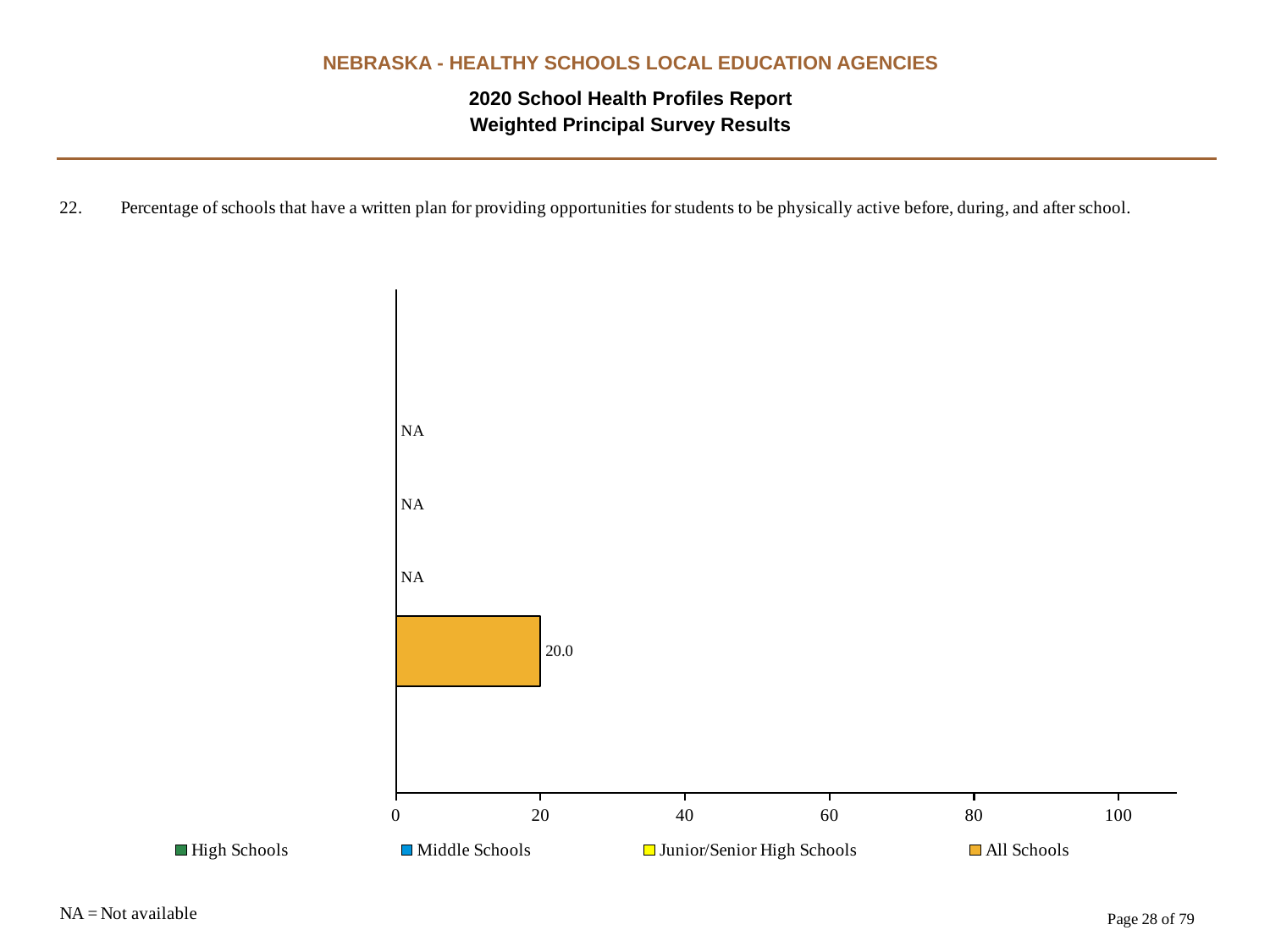
What kind of chart is shown on the slide? Bar chart What is the value for All Schools? 20.0 What is the highest value shown on the x axis? 100 What is shown for Junior/Senior High Schools? NA What is shown for High Schools? NA How many series does the legend list? 4 Is the value for All Schools greater or less than 40? less What is shown for Middle Schools? NA How many series are marked NA on the chart? 3 Which series is the only one with a plotted bar? All Schools